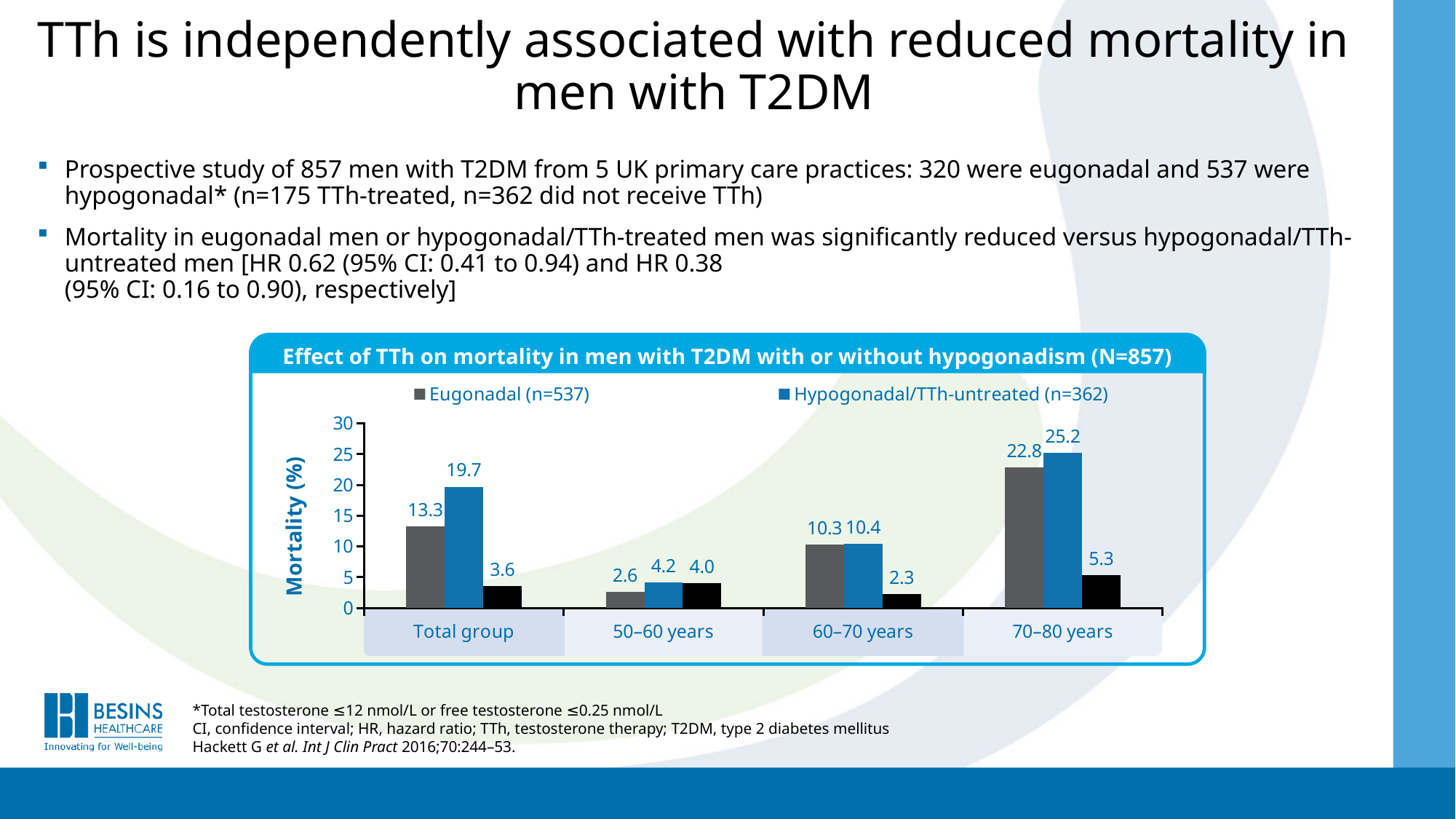
In the 70–80 years group, what is the difference between the Hypogonadal/TTh-untreated and Eugonadal values? 2.4 In the 70–80 years group, which is larger: the Eugonadal value or the Hypogonadal/TTh-untreated value? Hypogonadal/TTh-untreated How many series does the chart legend list? 2 Which category has the lowest value for the Eugonadal series? 50–60 years What is the mortality (%) for the Eugonadal series in the Total group? 13.3 What is the mortality (%) for the Hypogonadal/TTh-untreated series in the 70–80 years group? 25.2 In the Total group, how much higher is the Hypogonadal/TTh-untreated value than the Eugonadal value? 6.4 What kind of chart is shown on the slide? Bar chart What is the mortality (%) for the Eugonadal series in the 60–70 years group? 10.3 How many categories are shown on the x axis of the chart? 4 What is the mortality (%) for the Hypogonadal/TTh-untreated series in the 50–60 years group? 4.2 Which category has the highest value for the Hypogonadal/TTh-untreated series? 70–80 years